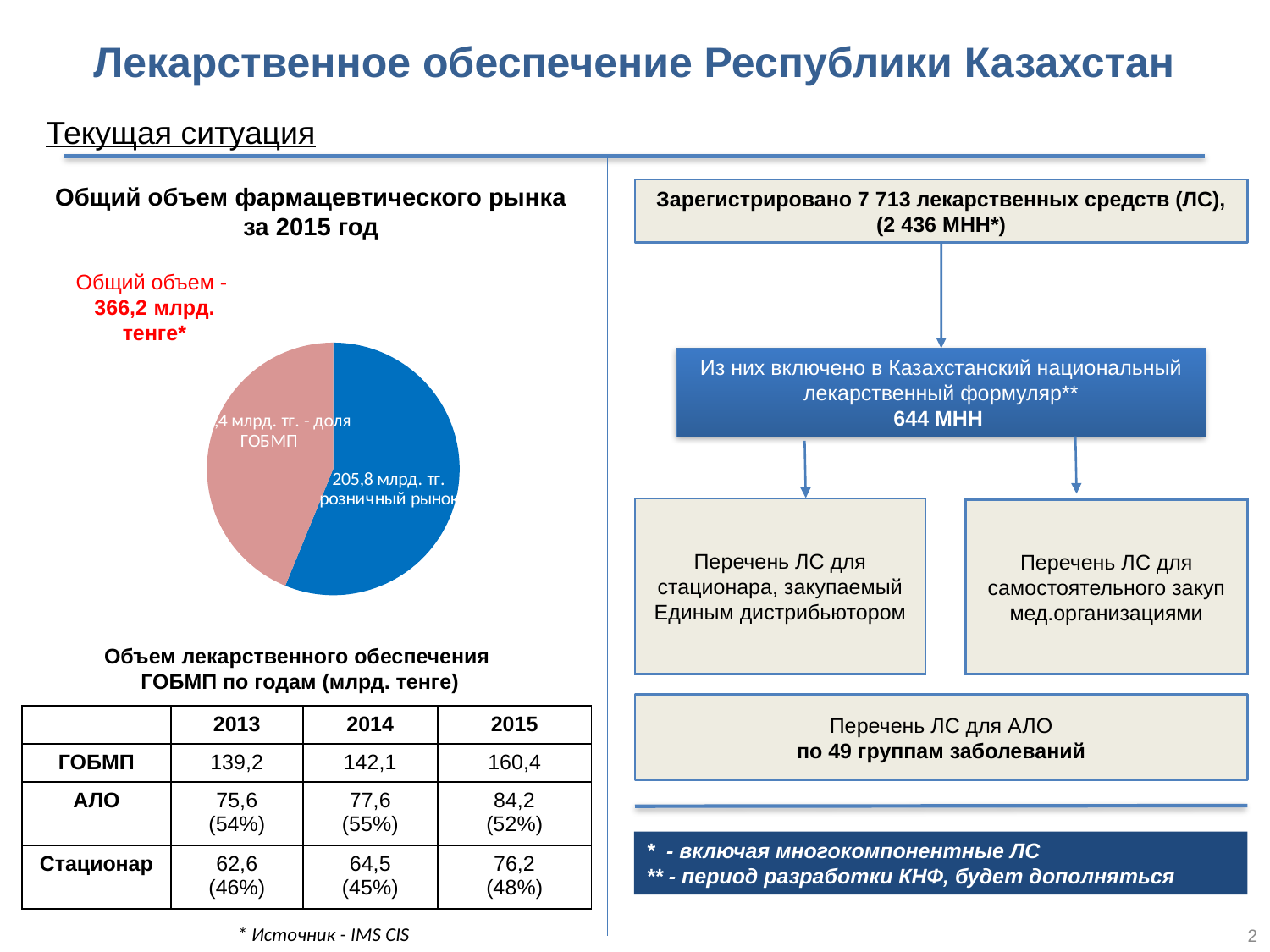
What colour is the 'розничный рынок' slice of the pie chart? blue What kind of chart is shown under the title 'Общий объем фармацевтического рынка за 2015 год'? pie chart What total volume is stated next to the pie chart? 366,2 млрд. тенге Which slice of the pie chart is the largest? розничный рынок How many slices does the pie chart have? 2 In the pie chart, which is larger: the 'розничный рынок' slice or the 'доля ГОБМП' slice? розничный рынок Which slice of the pie chart is the smallest? доля ГОБМП What value is labelled for the 'розничный рынок' slice of the pie chart? 205,8 млрд. тг.